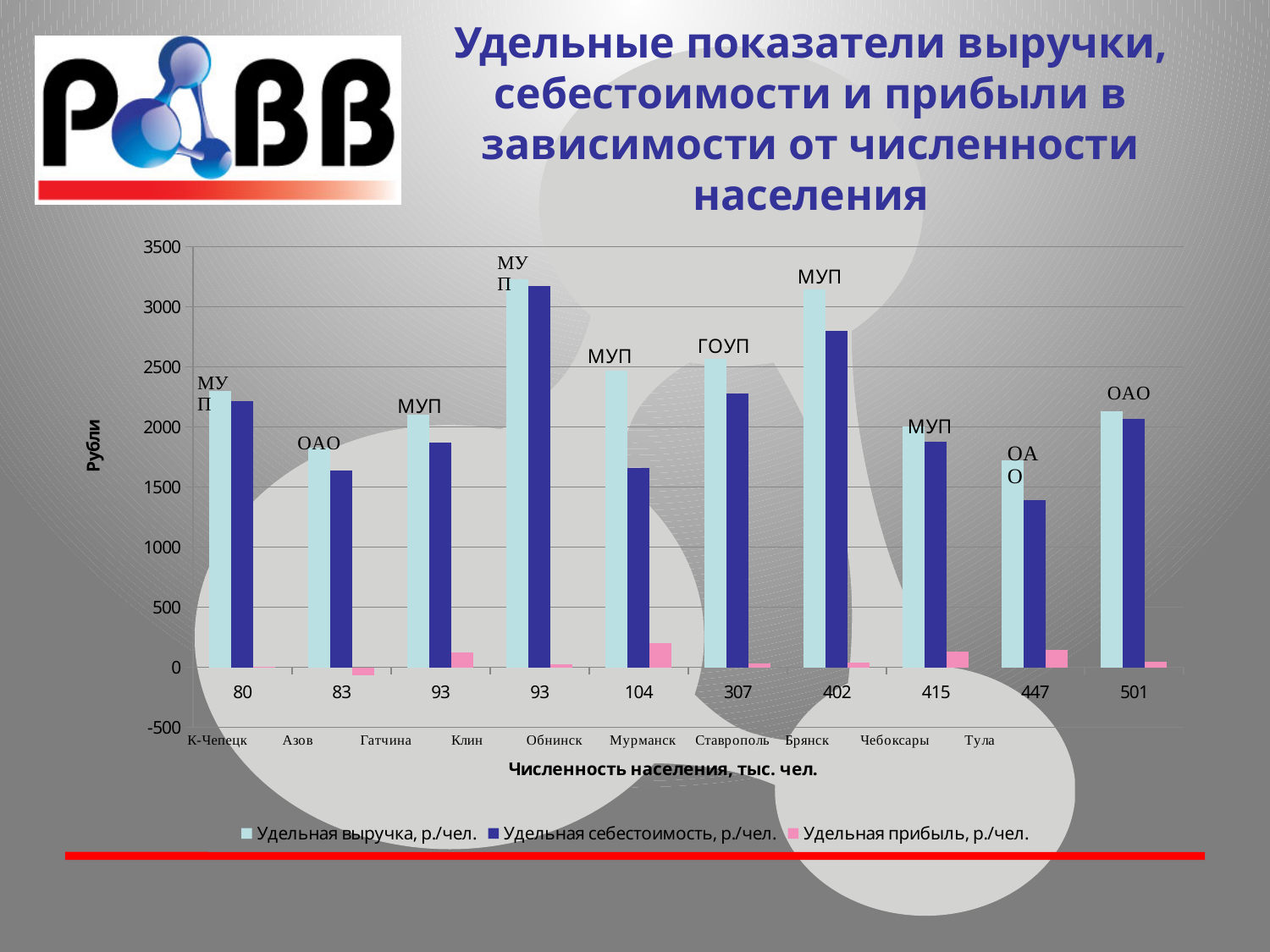
Which city has the highest value for Удельная себестоимость, р./чел.? Клин What is the title of the x axis of the chart? Численность населения, тыс. чел. What kind of chart is shown on the slide? bar chart For Обнинск, which is larger: Удельная выручка, р./чел. or Удельная себестоимость, р./чел.? Удельная выручка, р./чел. Which city has the lowest value for Удельная себестоимость, р./чел.? Чебоксары Which city has the larger value for Удельная себестоимость, р./чел.: Ставрополь or Брянск? Ставрополь How many cities (categories) are plotted along the x axis? 10 How many series does the legend list? 3 Is the value of Удельная себестоимость, р./чел. for Обнинск greater or less than 2000? less Is the value of Удельная выручка, р./чел. for Клин greater or less than 3000? greater Is the value of Удельная себестоимость, р./чел. for Чебоксары greater or less than 1500? less